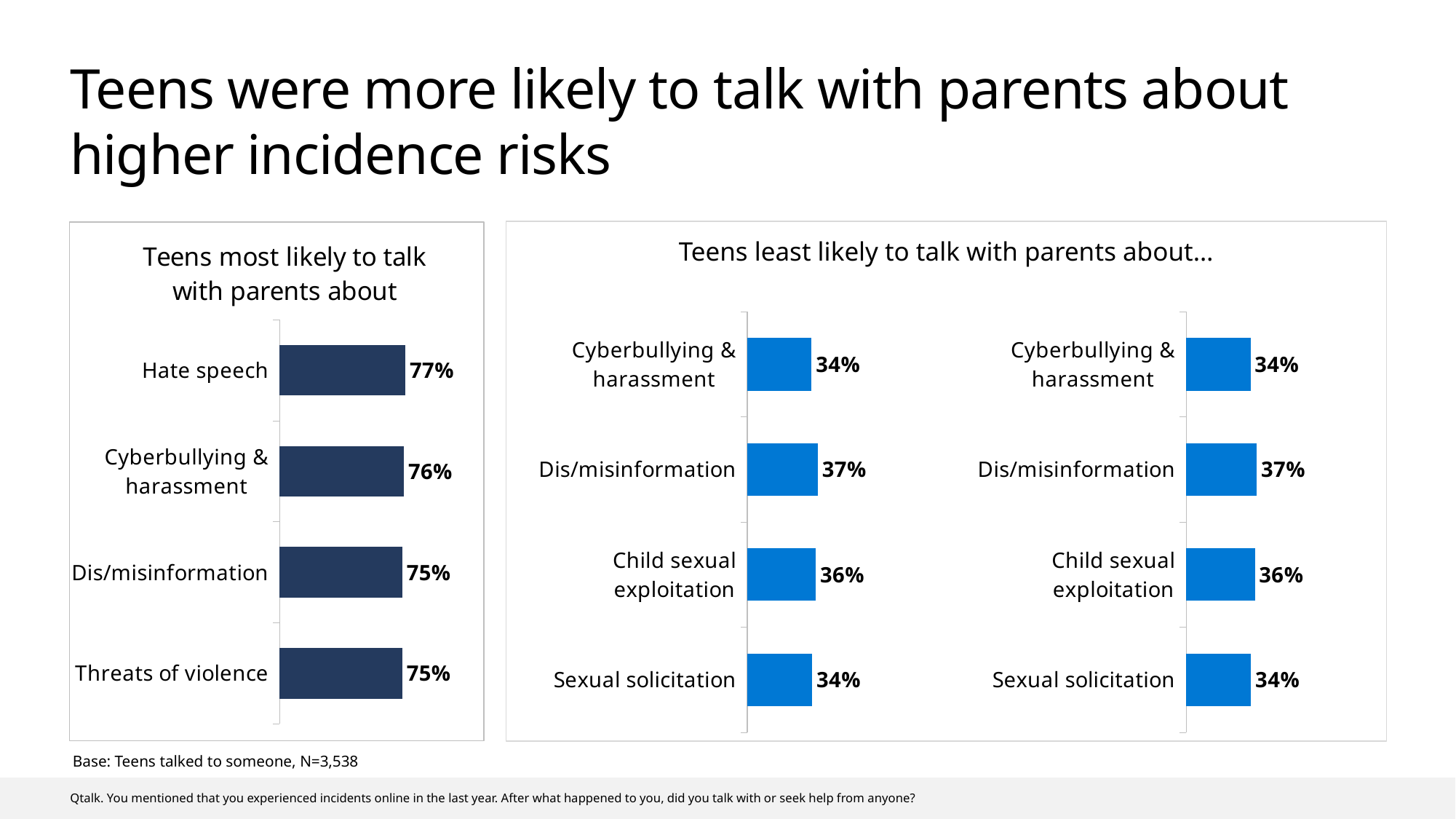
In the left-hand chart of the 'Teens least likely to talk with parents about...' panel, what is the difference between Dis/misinformation and Sexual solicitation? 3 percentage points In the 'Teens most likely to talk with parents about' chart, what percentage is shown for Hate speech? 77% In the 'Teens most likely to talk with parents about' chart, which is larger: Hate speech or Cyberbullying & harassment? Hate speech In the 'Teens most likely to talk with parents about' chart, what is the value for Threats of violence? 75% How many categories are plotted in the 'Teens most likely to talk with parents about' chart? 4 In the left-hand chart of the 'Teens least likely to talk with parents about...' panel, what is the value for Dis/misinformation? 37% In the 'Teens most likely to talk with parents about' chart, what is the difference between Hate speech and Dis/misinformation? 2 percentage points In the left-hand chart of the 'Teens least likely to talk with parents about...' panel, what percentage is shown for Child sexual exploitation? 36% In the left-hand chart of the 'Teens least likely to talk with parents about...' panel, which category has the highest value? Dis/misinformation What type of chart is the 'Teens most likely to talk with parents about' chart? Bar chart In the 'Teens most likely to talk with parents about' chart, which category has the highest value? Hate speech How many categories are plotted in the right-hand chart of the 'Teens least likely to talk with parents about...' panel? 4